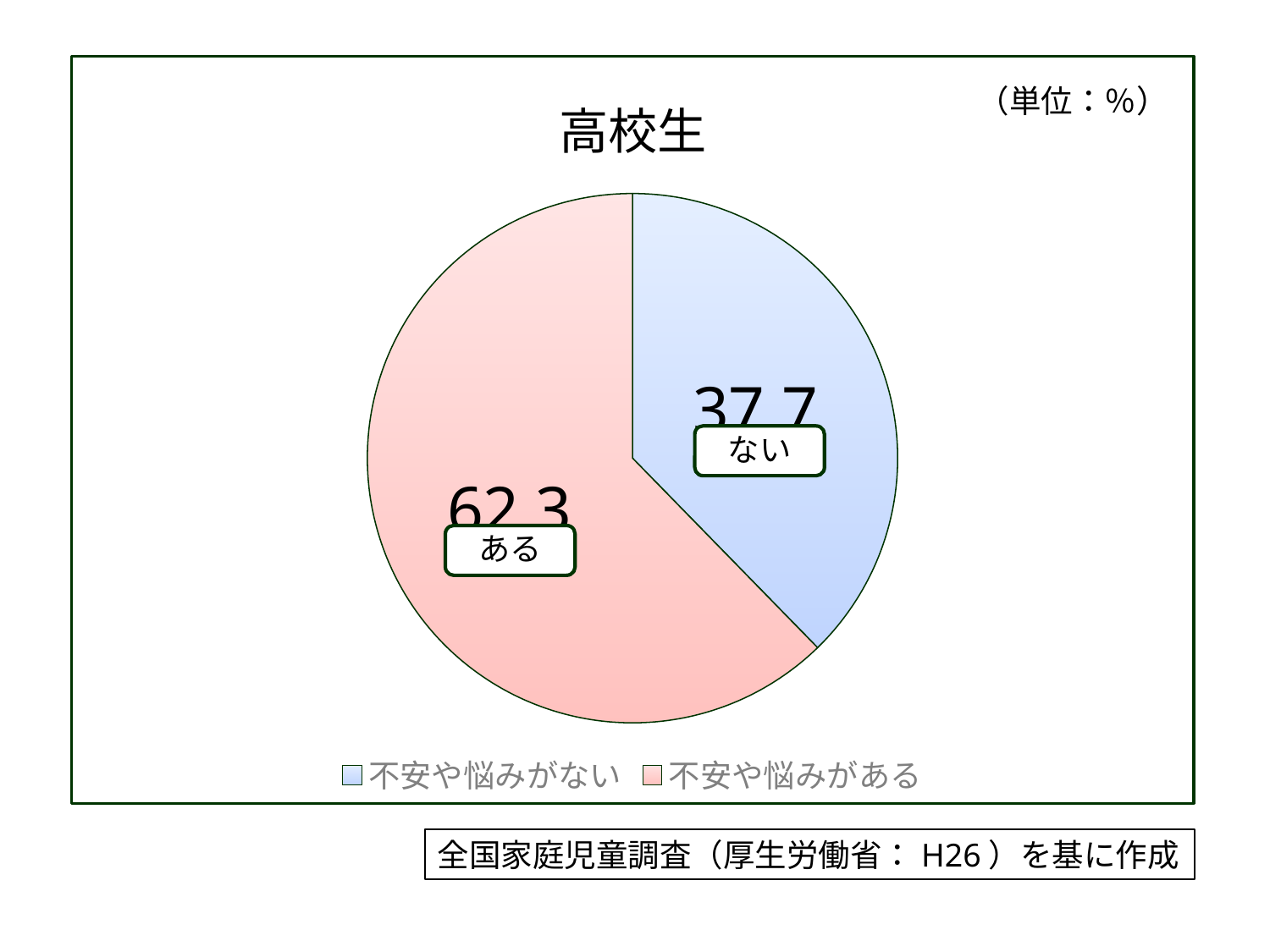
What is the difference between the values for 不安や悩みがある and 不安や悩みがない? 24.6 Which category has the largest slice of the pie? 不安や悩みがある How many entries does the legend list? 2 What is the value for 不安や悩みがある? 62.3 Which is larger, the value for 不安や悩みがある or the value for 不安や悩みがない? 不安や悩みがある Which category has the smallest slice of the pie? 不安や悩みがない What share of the pie does the 不安や悩みがある slice represent? 62.3% What unit is indicated for the values in the chart? % What type of chart is shown on the slide? pie chart How many slices does the pie chart have? 2 What is the value for 不安や悩みがない? 37.7 What is the title of the chart? 高校生